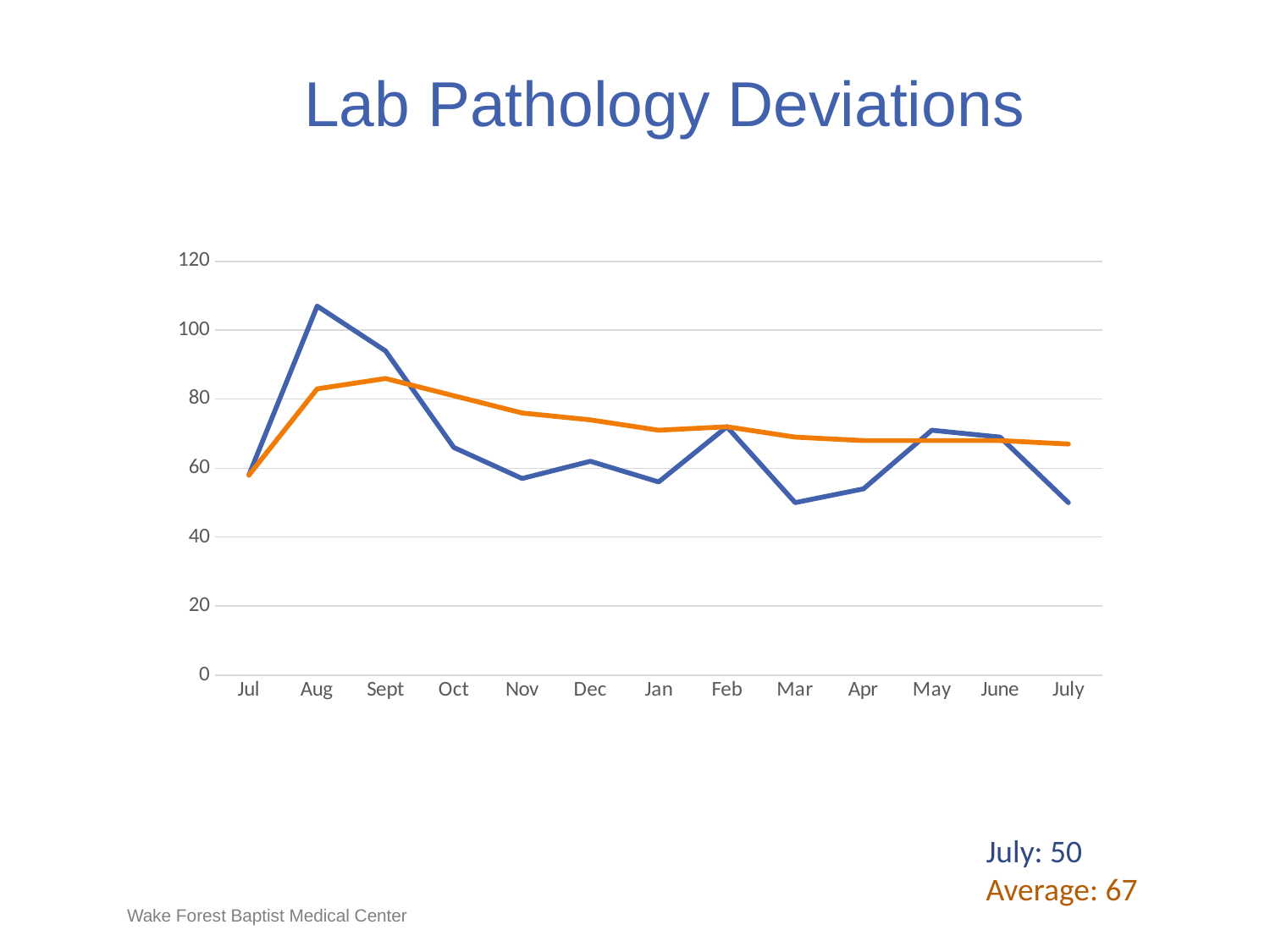
What is the title of the chart? Lab Pathology Deviations How many lines are plotted on the chart? 2 What is the value of the orange Average line at July? 67 What is the difference between the Average (67) and the July value (50)? 17 Does the orange Average line rise or fall from Sept to July? fall Is the blue line's value for Oct greater or less than 80? less In which month does the blue line reach its highest value? Aug What kind of chart is shown on the slide? line chart How many months are plotted along the x axis? 13 What is the value of the blue line for July (the last point)? 50 On the blue line, which is larger, the value for Feb or the value for Mar? Feb Is the blue line's value for Aug greater or less than 100? greater